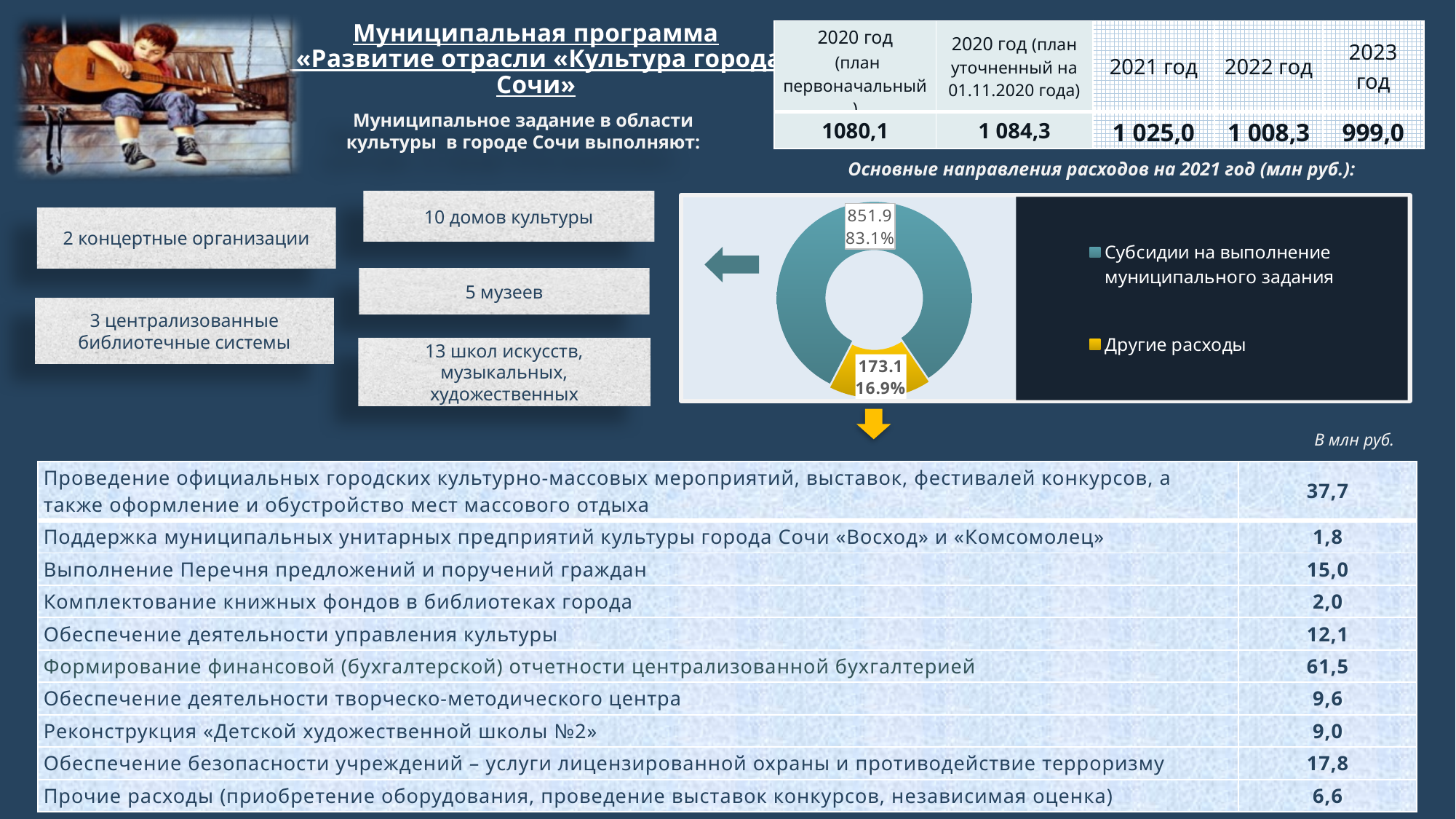
What share of the pie does «Субсидии на выполнение муниципального задания» take? 83.1% What is the title above the pie chart? Основные направления расходов на 2021 год (млн руб.): How many categories does the pie chart show? 2 What is the difference between the values for «Субсидии на выполнение муниципального задания» and «Другие расходы» in the pie chart? 678.8 What colour is the «Другие расходы» slice in the pie chart? Yellow Which category has the smallest slice in the pie chart? Другие расходы What is the value for «Другие расходы» in the pie chart? 173.1 Which is larger in the pie chart: «Субсидии на выполнение муниципального задания» or «Другие расходы»? Субсидии на выполнение муниципального задания What share of the pie does «Другие расходы» take? 16.9% What kind of chart is shown on the slide? Pie chart (doughnut) What is the value for «Субсидии на выполнение муниципального задания» in the pie chart? 851.9 Which category has the largest slice in the pie chart? Субсидии на выполнение муниципального задания